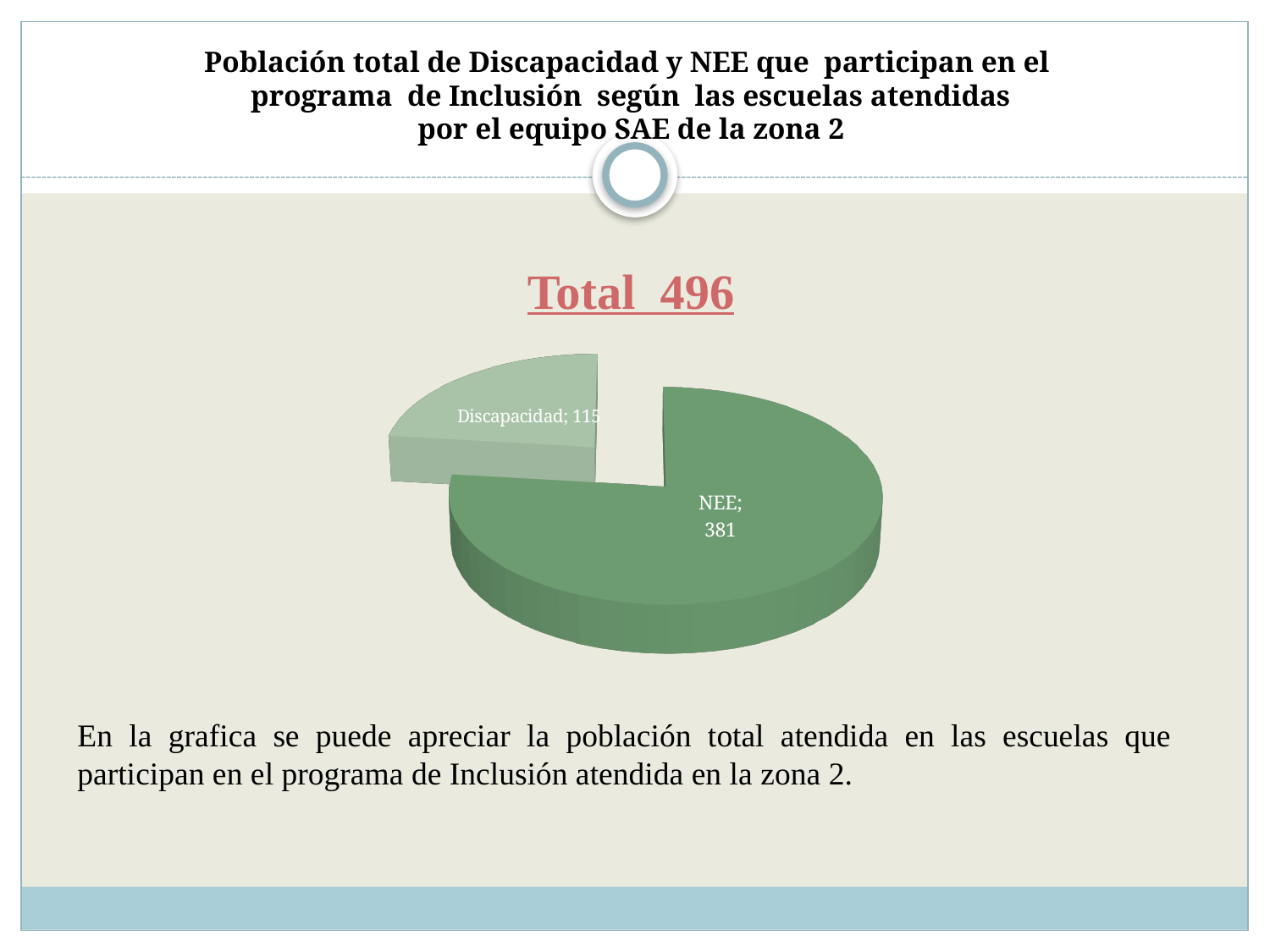
What is the value for Discapacidad in the pie chart? 115 What share of the pie does the Discapacidad slice represent, rounded to the nearest whole percent? 23% Which is larger, the value for NEE or the value for Discapacidad? NEE What type of chart is shown on the slide? pie chart How many slices does the pie chart have? 2 What total is printed above the pie chart? 496 What is the value for NEE in the pie chart? 381 Which slice of the pie chart is pulled out (exploded) from the rest of the pie? Discapacidad What is the difference between the NEE value and the Discapacidad value? 266 Which slice of the pie chart is the largest? NEE What is the sum of the two slice values in the pie chart? 496 Which slice of the pie chart is the smallest? Discapacidad